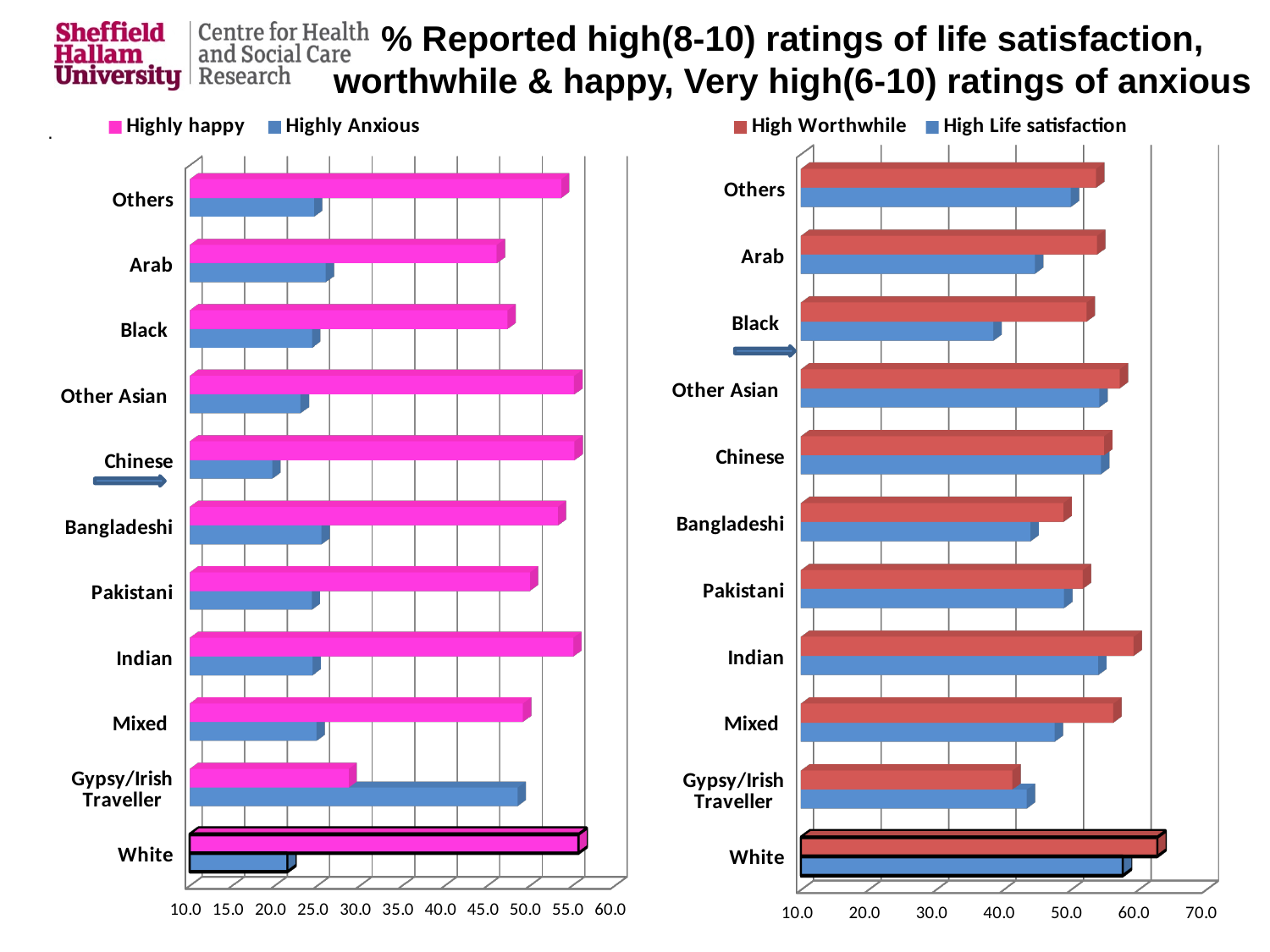
On the right chart, is the High Worthwhile value for White greater or less than 60.0? greater On the left chart, is the Highly Anxious value for Gypsy/Irish Traveller greater or less than 45.0? greater On the left chart, is the Highly Anxious value for Chinese greater or less than 25.0? less How many ethnic group categories are shown on the right chart (High Worthwhile / High Life satisfaction)? 11 What kind of chart is the left chart (Highly happy / Highly Anxious)? Bar chart On the right chart, which category has the highest High Worthwhile value? White On the right chart, which series is shown in red? High Worthwhile On the left chart, which category has the highest Highly Anxious value? Gypsy/Irish Traveller On the left chart, for Gypsy/Irish Traveller, which is larger: Highly happy or Highly Anxious? Highly Anxious How many series does the legend of the left chart list? 2 On the left chart, which category has the lowest Highly happy value? Gypsy/Irish Traveller On the right chart, which category has the lowest High Life satisfaction value? Black